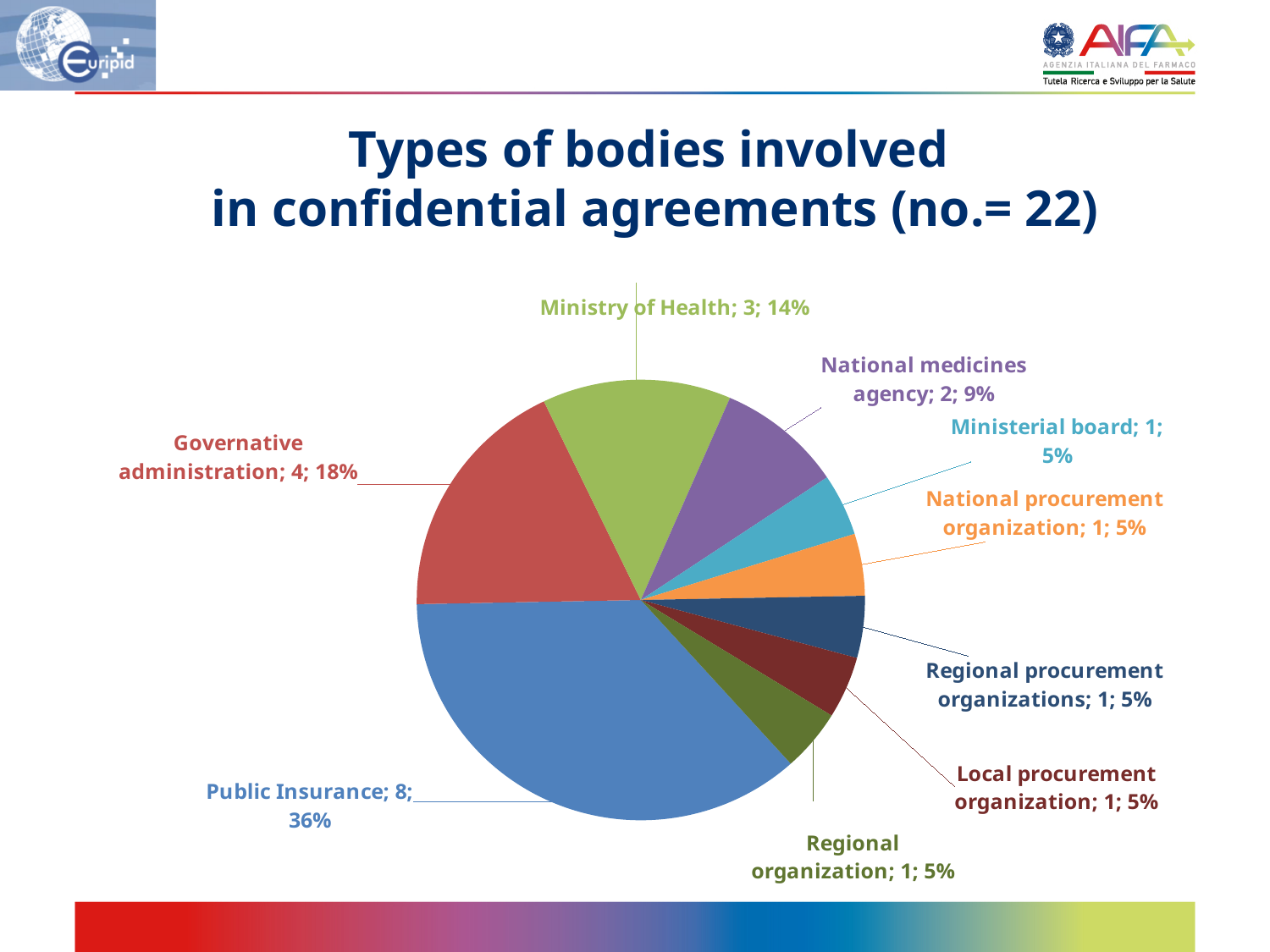
How many categories (slices) does the pie chart have? 9 What percentage share does Governative administration have? 18% Which is larger, the count for Ministry of Health or the count for National medicines agency? Ministry of Health What is the count for Public Insurance? 8 What is the difference in count between Public Insurance and Governative administration? 4 What percentage share does National medicines agency have? 9% How many categories have a count of 1? 5 What is the title of the chart? Types of bodies involved in confidential agreements (no.= 22) What kind of chart is shown on the slide? pie chart Which category has the largest share of the pie? Public Insurance What is the count for Ministry of Health? 3 What percentage share does Ministerial board have? 5%